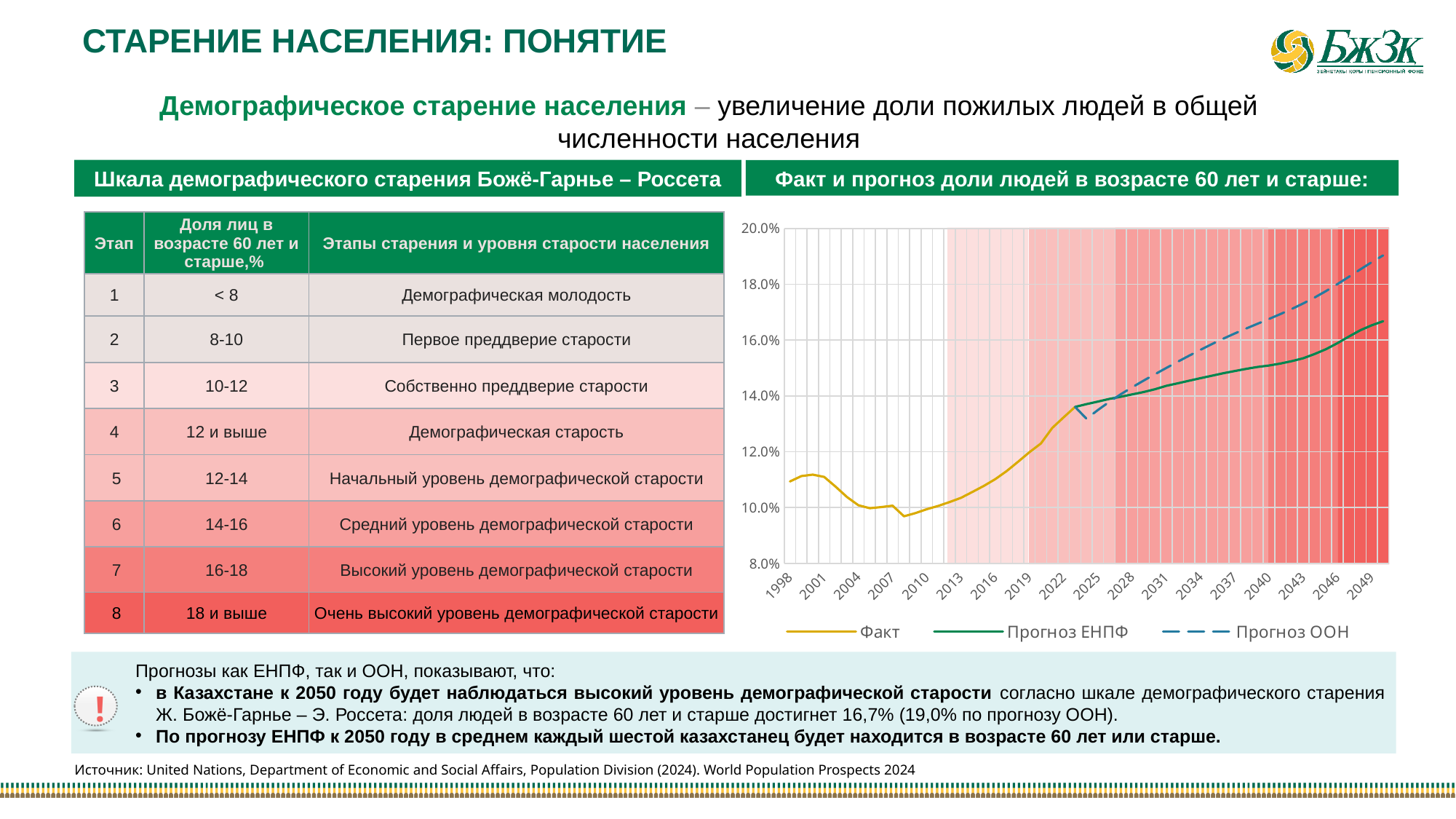
What are the three series listed in the chart legend? Факт, Прогноз ЕНПФ, Прогноз ООН How many series does the chart legend list? 3 Is the value of Прогноз ООН in 2025 greater or less than 14.0%? less Is the value of Прогноз ООН in 2049 greater or less than 18.0%? greater Is the value of Факт in 2022 greater or less than 12.0%? greater Which series in the chart is drawn as a dashed line? Прогноз ООН In 2049, which series is higher: Прогноз ЕНПФ or Прогноз ООН? Прогноз ООН What is the highest value shown on the chart's vertical axis? 20.0% What kind of chart is shown on the slide? line chart Does the Прогноз ЕНПФ line rise or fall from 2025 to 2049? rise